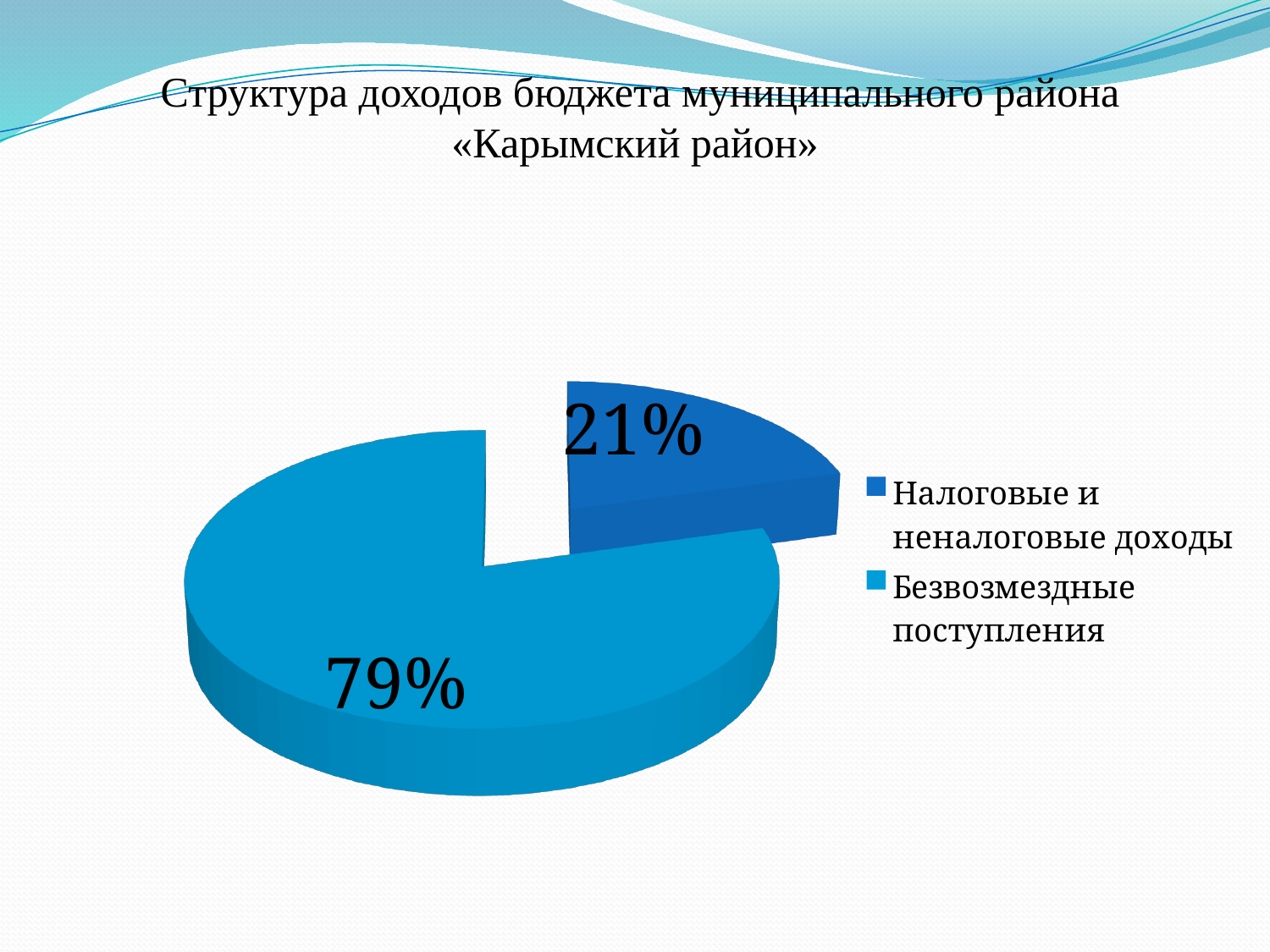
What is the difference in percentage points between «Безвозмездные поступления» and «Налоговые и неналоговые доходы»? 58 How many entries does the legend list? 2 Which is larger: «Налоговые и неналоговые доходы» or «Безвозмездные поступления»? Безвозмездные поступления What is the title of the slide containing the chart? Структура доходов бюджета муниципального района «Карымский район» Which category has the largest slice? Безвозмездные поступления What kind of chart is shown on the slide? pie chart What share of the pie does «Налоговые и неналоговые доходы» have? 21% How many slices does the pie chart have? 2 Which category has the smallest slice? Налоговые и неналоговые доходы Which slice is pulled out (exploded) from the pie? Налоговые и неналоговые доходы What share of the pie does «Безвозмездные поступления» have? 79%